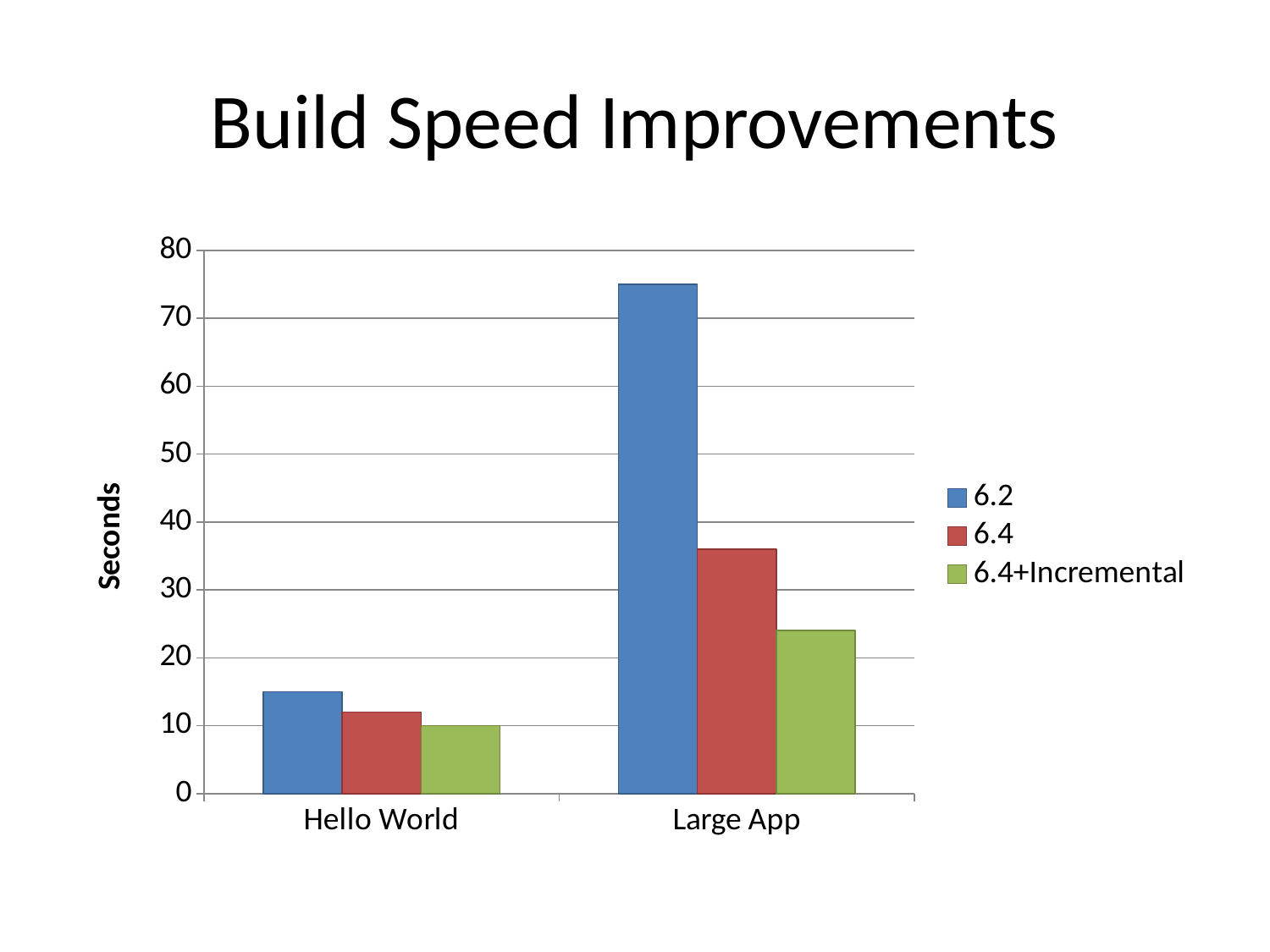
Is the value for 6.4+Incremental in the Large App category greater or less than 20? greater What is the title of the chart? Build Speed Improvements What is the label on the vertical axis? Seconds Is the value for 6.4 in the Large App category greater or less than 40? less Is the value for 6.2 in the Hello World category greater or less than 20? less Which series has the highest value in the Large App category? 6.2 How many categories are shown on the x axis? 2 What kind of chart is shown on the slide? bar chart Which series has the lowest value in the Hello World category? 6.4+Incremental How many series does the legend list? 3 What is the value for 6.4+Incremental in the Hello World category? 10